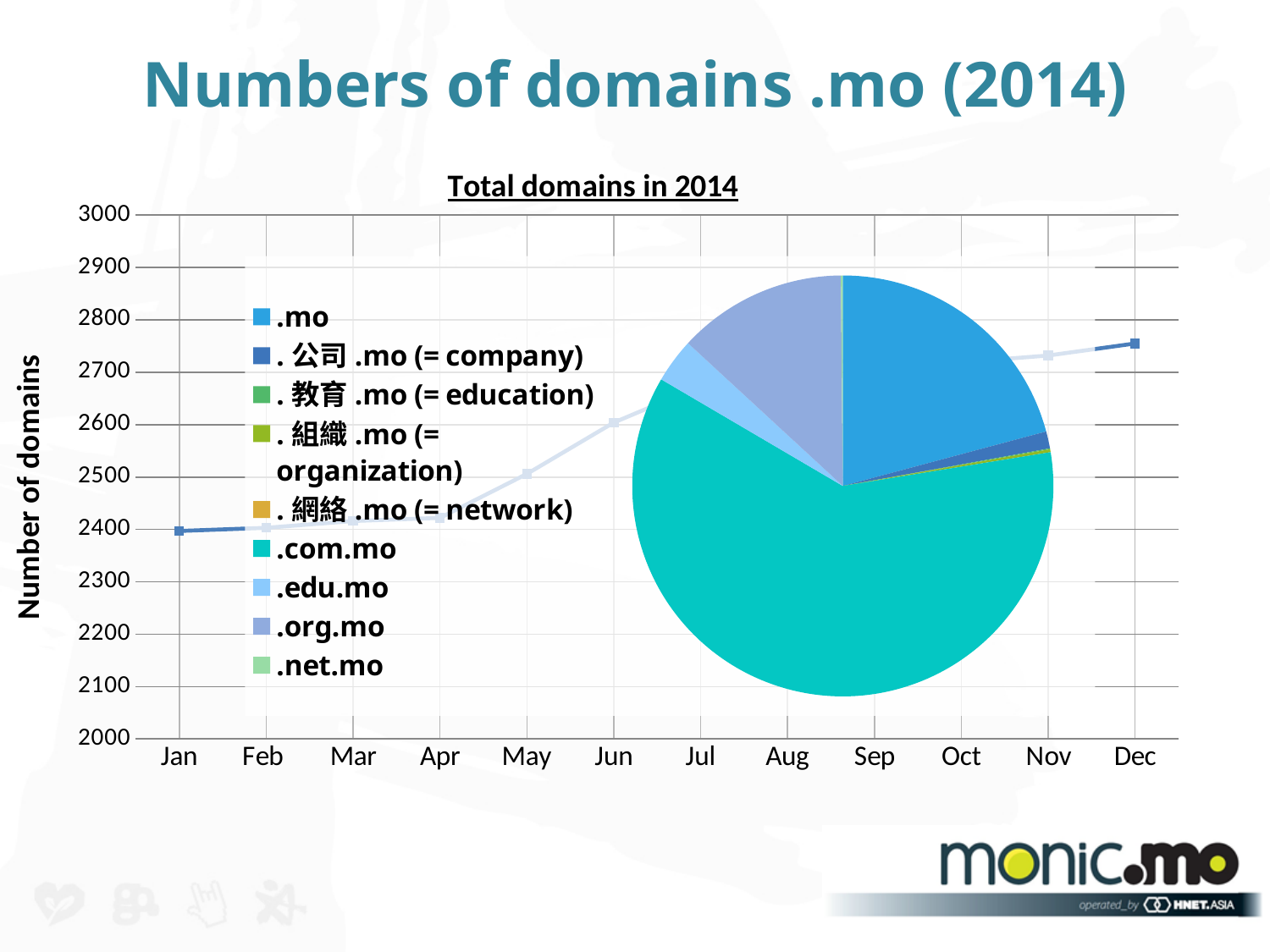
In the 'Total domains in 2014' line chart, which is larger, the value for Jan or the value for Dec? Dec How many months are plotted on the x axis of the 'Total domains in 2014' line chart? 12 In the 'Total domains in 2014' line chart, is the value for Jan greater or less than 2500? less In the 'Total domains in 2014' line chart, do the values rise or fall from Jan to Dec? rise In the pie chart on the right of the slide, which category has the largest slice? .com.mo How many entries does the legend of the pie chart list? 9 In the 'Total domains in 2014' line chart, is the value for Jun greater or less than 2500? greater What kind of chart is the 'Total domains in 2014' chart with the months along the x axis? line chart In the 'Total domains in 2014' line chart, which month has the highest value? Dec In the 'Total domains in 2014' line chart, is the value for Dec greater or less than 2700? greater What is the label on the y axis of the 'Total domains in 2014' line chart? Number of domains